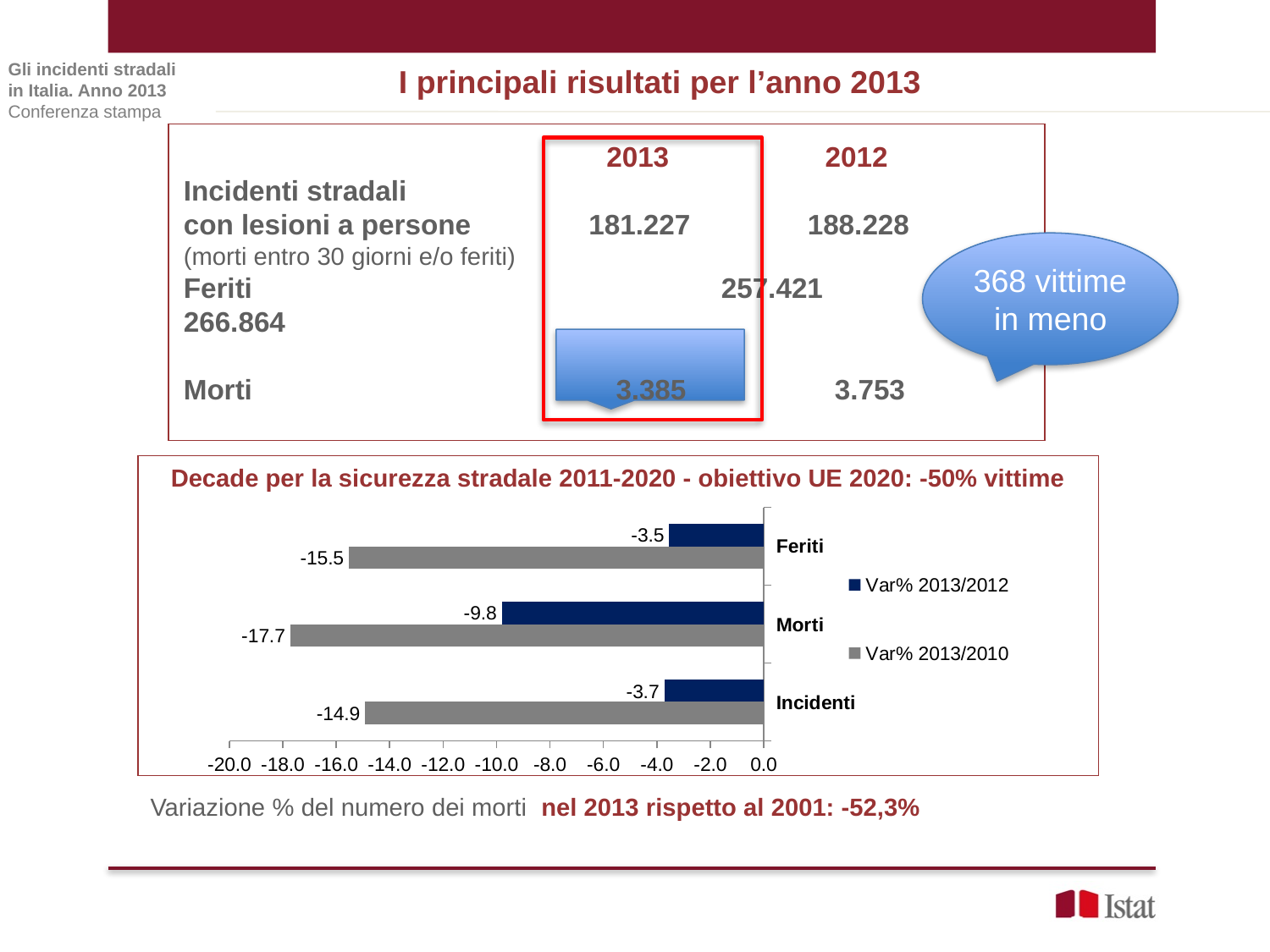
Which category has the most negative Var% 2013/2012 value? Morti How many series does the legend of the bar chart list? 2 What is the Var% 2013/2012 value for Morti? -9.8 What is the Var% 2013/2010 value for Incidenti? -14.9 What is the difference between the Var% 2013/2010 and Var% 2013/2012 values for Morti? 7.9 Which is more negative: the Var% 2013/2010 value for Feriti or for Incidenti? Feriti What is the title of the bar chart? Decade per la sicurezza stradale 2011-2020 - obiettivo UE 2020: -50% vittime What is the Var% 2013/2010 value for Feriti? -15.5 What is the Var% 2013/2012 value for Feriti? -3.5 Which category has the lowest (most negative) Var% 2013/2010 value? Morti How many categories are shown in the bar chart? 3 What type of chart is shown on the slide? bar chart